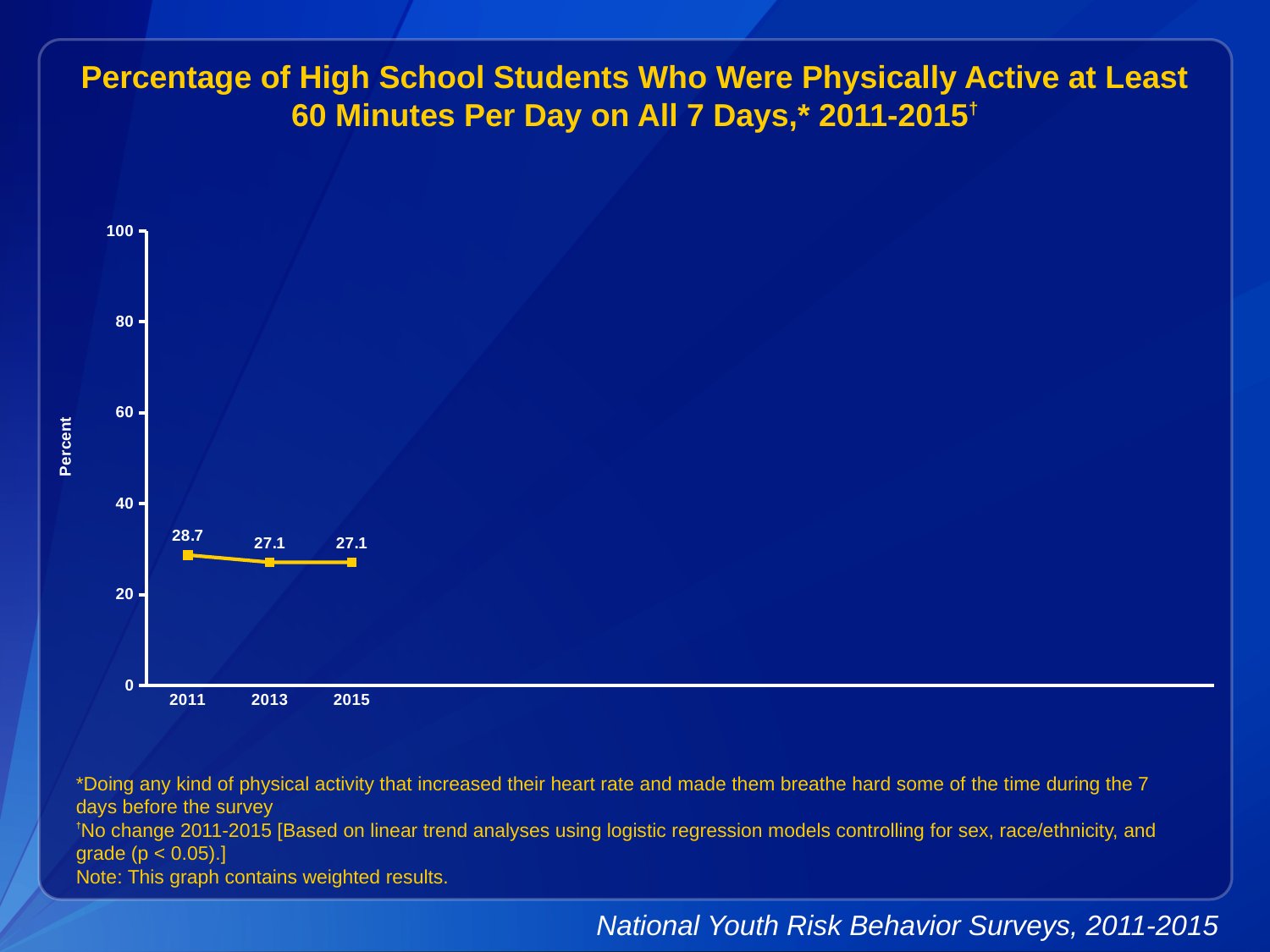
Which year has the highest value? 2011 Is the value for 2015 greater or less than 20? greater Is the value for 2011 greater or less than 40? less What is the value for 2015? 27.1 What kind of chart is shown? line chart What is the value for 2011? 28.7 What is the difference between the values for 2011 and 2013? 1.6 Which is larger, the value for 2011 or the value for 2015? 2011 What is the label on the vertical axis? Percent How many years are plotted on the chart? 3 Do the values rise or fall from 2011 to 2013? fall What is the value for 2013? 27.1